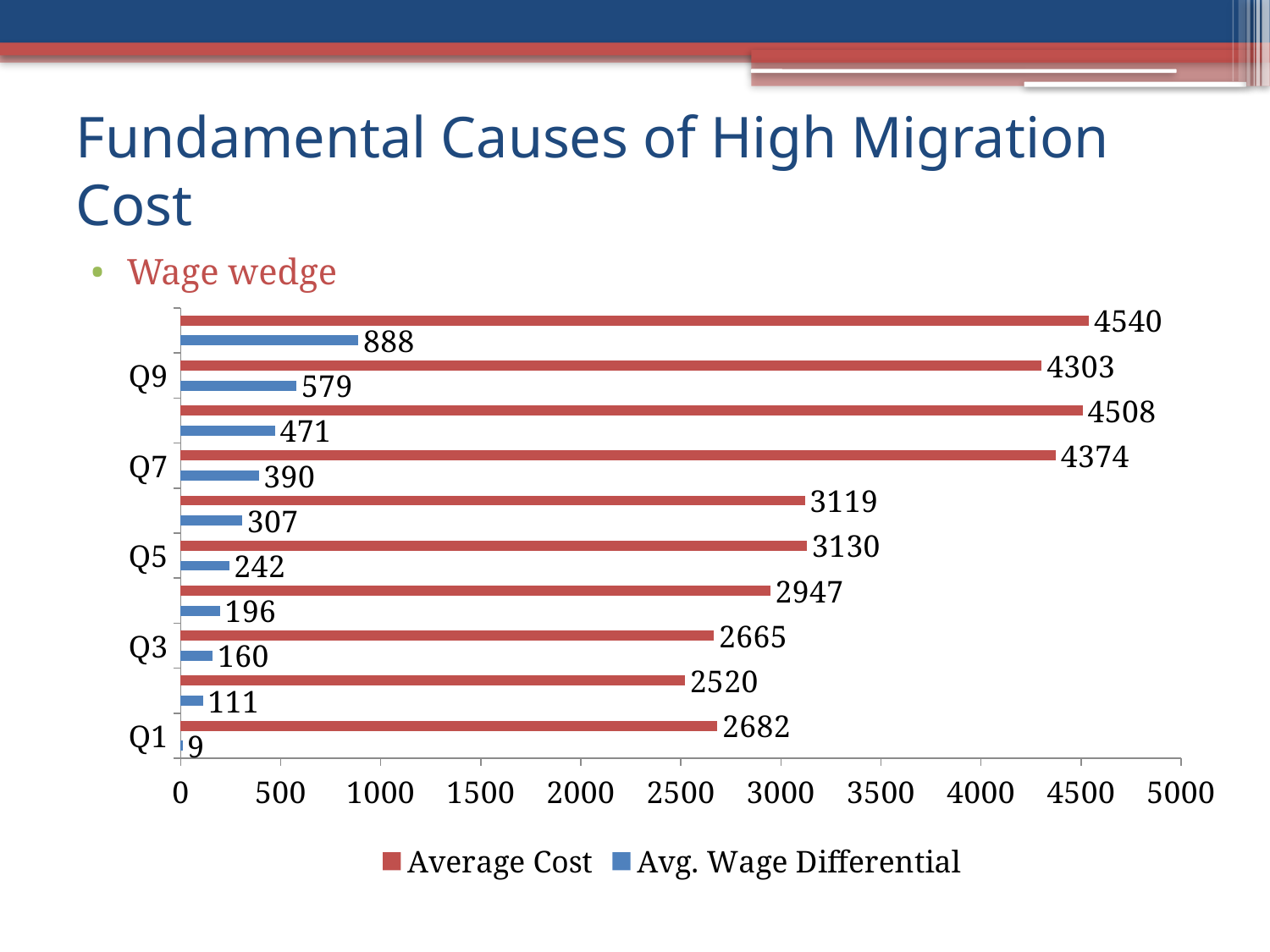
Which colour represents the Avg. Wage Differential series? Blue What is the Average Cost for Q7? 4374 What is the Avg. Wage Differential for Q5? 242 What kind of chart is shown on the slide? Bar chart What is the highest Average Cost value shown on the chart? 4540 How many series does the legend list? 2 What is the difference between the Average Cost for Q9 and the Average Cost for Q3? 1638 What is the Avg. Wage Differential for Q9? 579 What is the Average Cost for Q1? 2682 Which labeled quarter has the lowest Avg. Wage Differential? Q1 Is the Average Cost for Q7 greater or less than 4000? greater Which is larger, the Average Cost for Q5 or the Average Cost for Q3? Q5